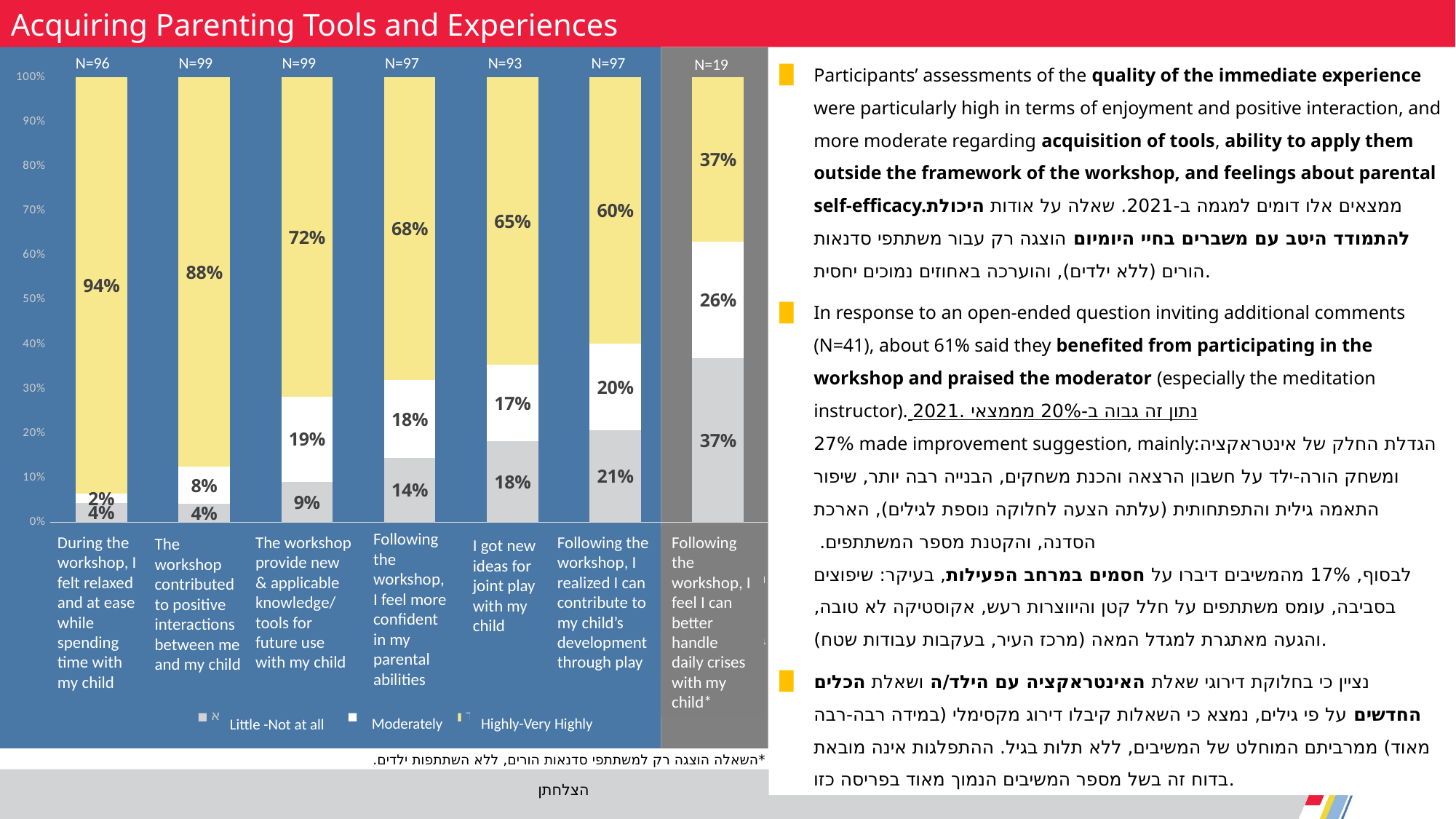
What is the 'Little-Not at all' value for 'Following the workshop, I feel I can better handle daily crises with my child'? 37% What is the sample size (N) shown above the bar for 'Following the workshop, I feel I can better handle daily crises with my child'? N=19 What is the 'Moderately' value for 'The workshop provide new & applicable knowledge/tools for future use with my child'? 19% How many series does the chart legend list? 3 What is the 'Highly-Very Highly' value for 'During the workshop, I felt relaxed and at ease while spending time with my child'? 94% Do the 'Highly-Very Highly' values rise or fall moving from left to right across the bars? Fall Which category has the highest 'Highly-Very Highly' value? During the workshop, I felt relaxed and at ease while spending time with my child How many categories (bars) are plotted in the chart? 7 Which is larger: the 'Little-Not at all' value for 'Following the workshop, I feel more confident in my parental abilities' or for 'Following the workshop, I realized I can contribute to my child's development through play'? Following the workshop, I realized I can contribute to my child's development through play What kind of chart is shown on the slide? Stacked bar chart What is the difference between the 'Highly-Very Highly' values for 'The workshop contributed to positive interactions between me and my child' and 'I got new ideas for joint play with my child'? 23% Which category has the lowest 'Highly-Very Highly' value? Following the workshop, I feel I can better handle daily crises with my child